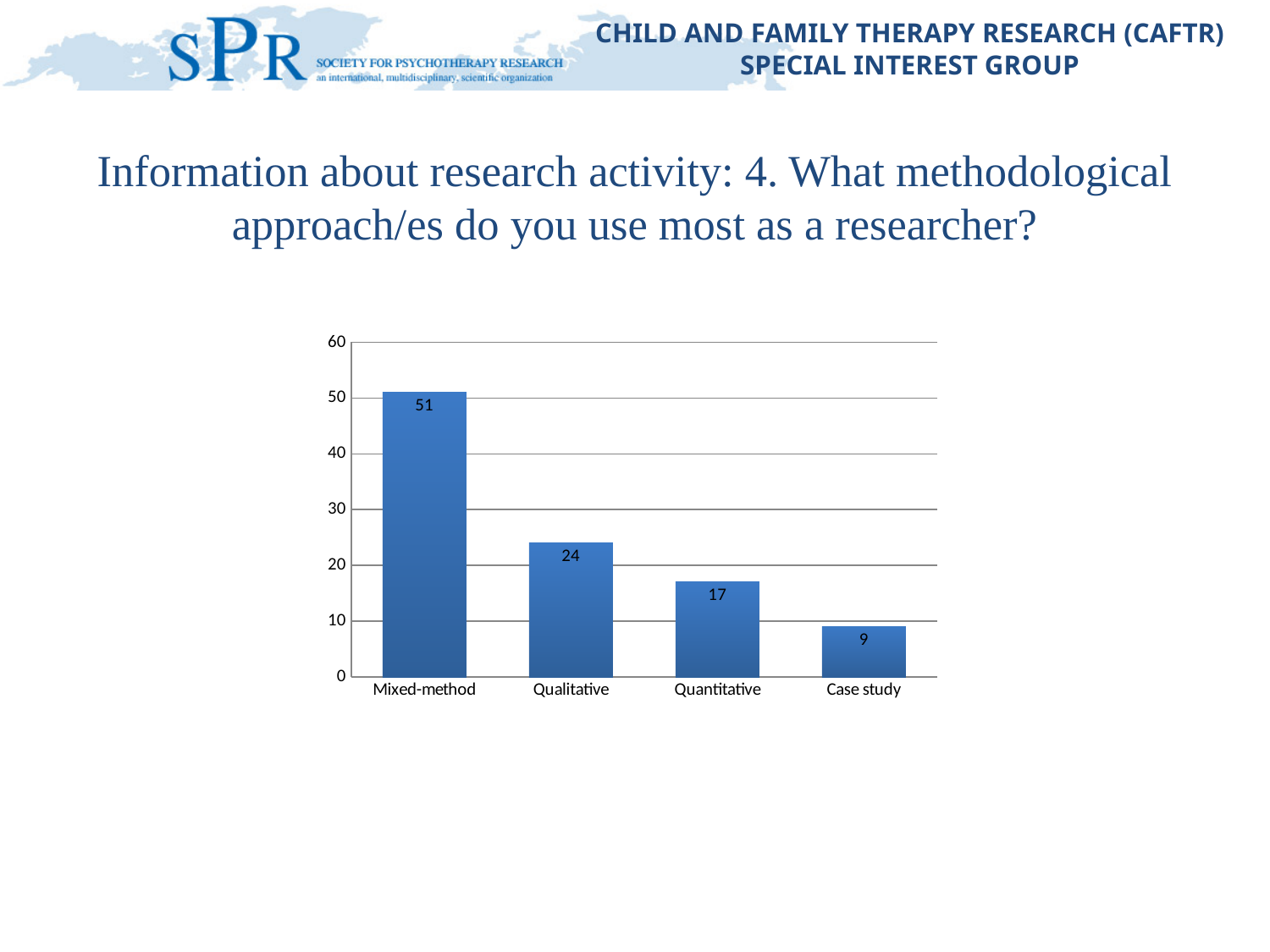
Which category has the highest value? Mixed-method Is the value for Mixed-method greater or less than 40? greater Which is larger, the value for Qualitative or the value for Quantitative? Qualitative What is the difference between the values for Mixed-method and Qualitative? 27 How many categories are shown on the x axis? 4 What is the value for Case study? 9 What is the value for Quantitative? 17 Which category has the lowest value? Case study What is the difference between the values for Quantitative and Case study? 8 What kind of chart is shown on the slide? bar chart What is the value for Qualitative? 24 What is the value for Mixed-method? 51